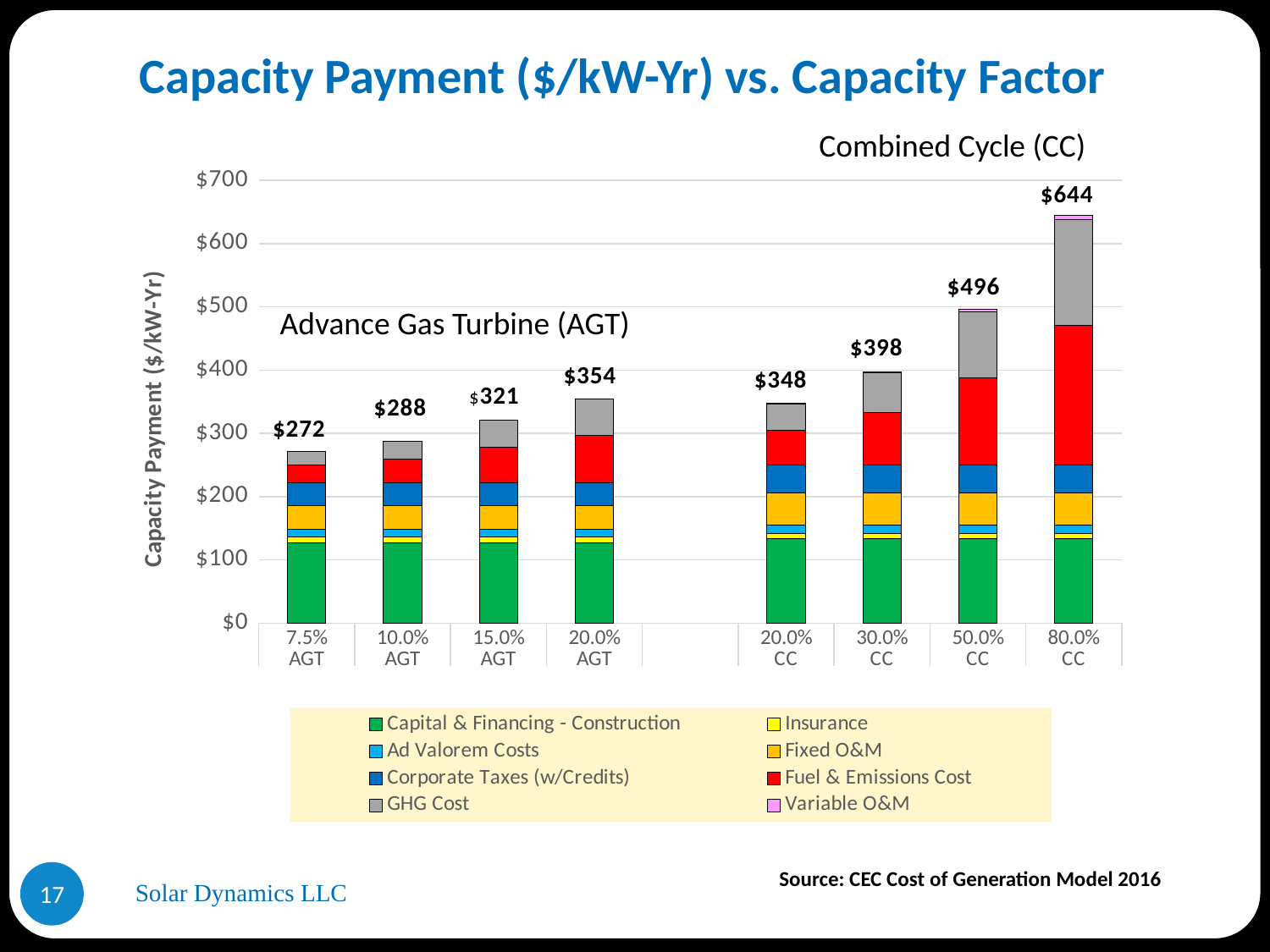
Which category has the lowest total capacity payment? 7.5% AGT What is the total capacity payment for 30.0% CC? $398 What is the total capacity payment for 15.0% AGT? $321 Which is larger, the total for 20.0% AGT or the total for 20.0% CC? 20.0% AGT What is the total capacity payment for 7.5% AGT? $272 What is the difference between the total for 50.0% CC and the total for 20.0% CC? $148 What is the total capacity payment for 80.0% CC? $644 What kind of chart is shown? Stacked bar chart Which category has the highest total capacity payment? 80.0% CC Do the total capacity payments rise or fall as the capacity factor increases within the CC group? Rise How many series does the legend list? 8 How many categories are shown on the x axis? 8